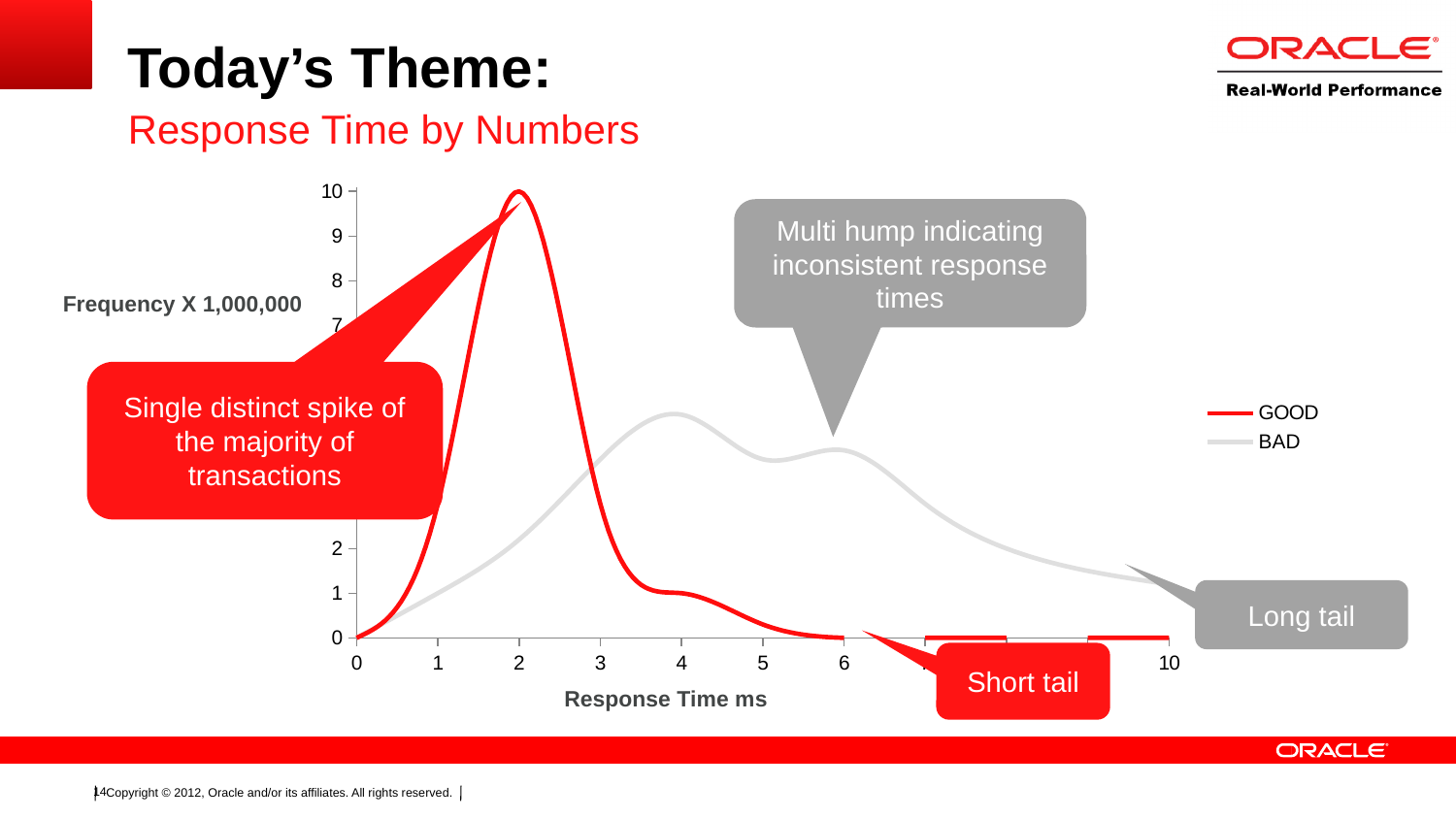
Is the value of the GOOD series at 6 ms greater or less than 1? less Is the value of the BAD series at 4 ms greater or less than 6? less What kind of chart is shown on the slide? line chart Which series reaches the higher peak, GOOD or BAD? GOOD At a response time of 4 ms, which series has the higher frequency, GOOD or BAD? BAD Is the value of the GOOD series at 2 ms greater or less than 5? greater What are the two series named in the legend? GOOD and BAD How many series does the legend list? 2 At a response time of 2 ms, which series has the higher frequency, GOOD or BAD? GOOD Does the GOOD series rise or fall between 2 ms and 6 ms on the x axis? fall What is the title of the x axis? Response Time ms